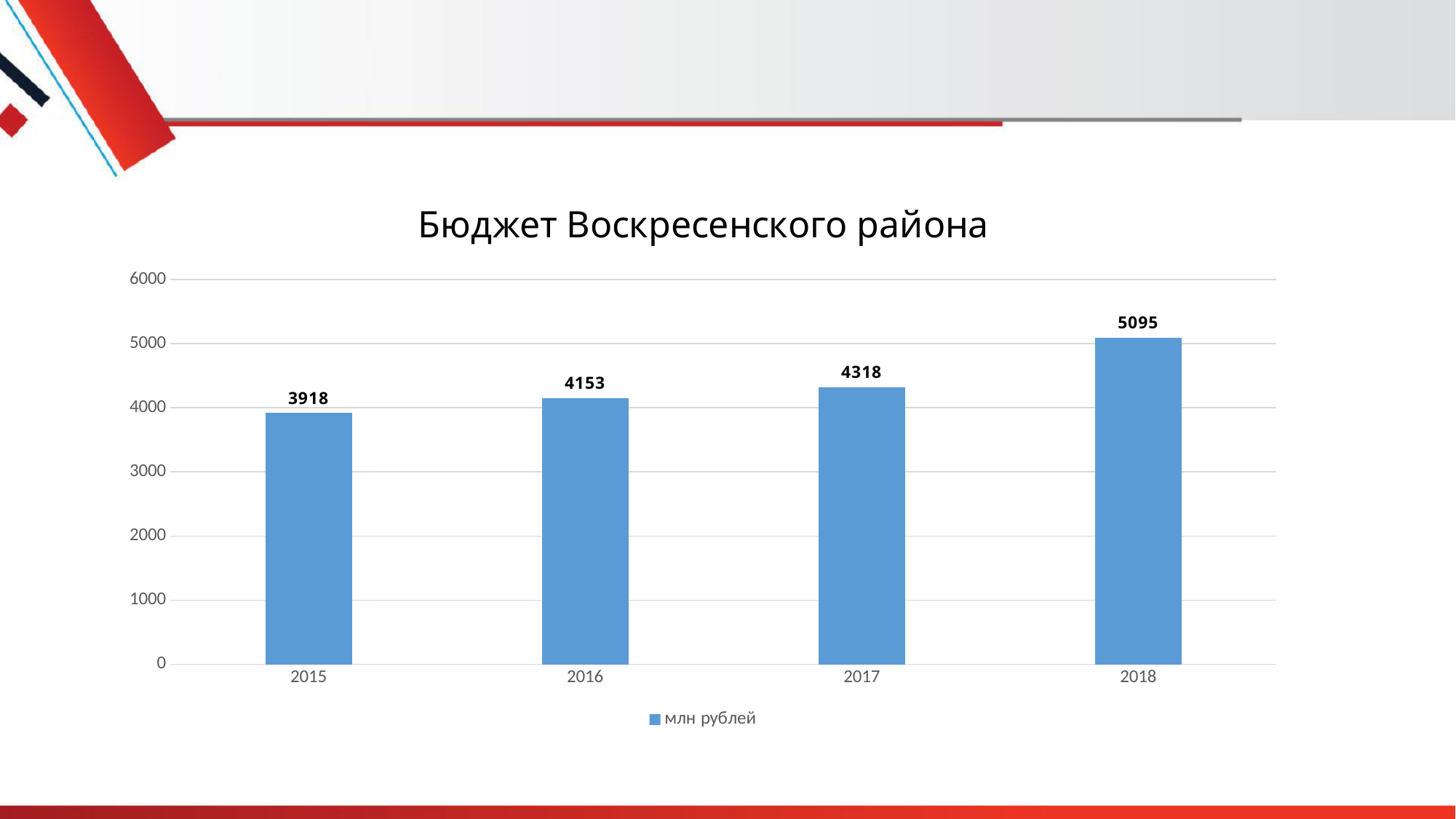
What is the difference between the values for 2018 and 2015? 1177 What is the value for 2017? 4318 Is the value for 2018 greater or less than 5000? greater Which year has the highest value? 2018 What is the value for 2015? 3918 What kind of chart is shown? bar chart What is the difference between the values for 2017 and 2016? 165 Which is larger, the value for 2016 or the value for 2017? 2017 Which year has the lowest value? 2015 How many years are shown on the x axis? 4 What is the value for 2018? 5095 Do the values rise or fall from 2015 to 2018? rise